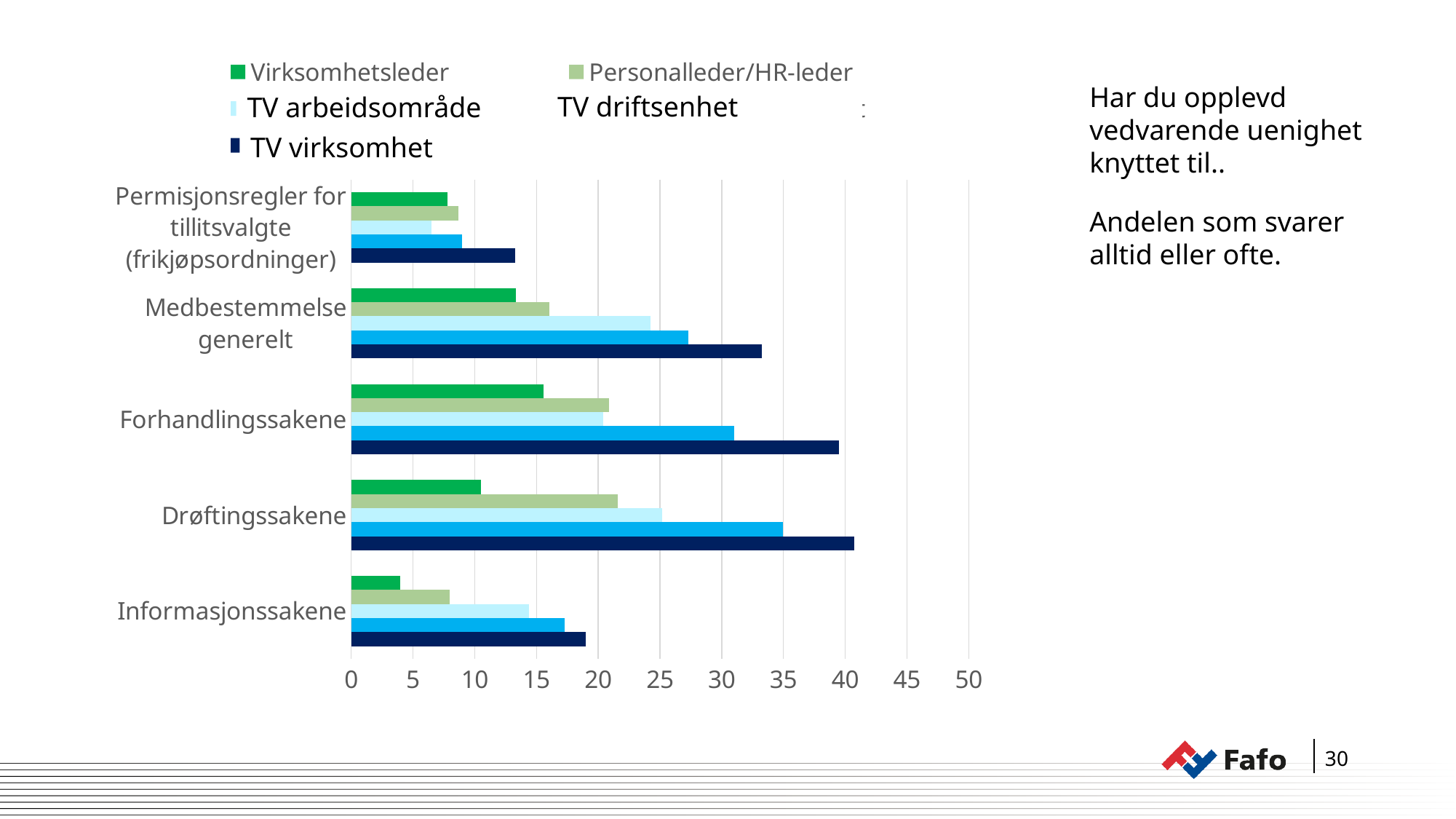
Is the value for TV virksomhet in Forhandlingssakene greater or less than 35? greater Which category has the lowest value for the Virksomhetsleder series? Informasjonssakene How many categories are shown on the vertical axis of the chart? 5 For Drøftingssakene, which is larger: TV arbeidsområde or Personalleder/HR-leder? TV arbeidsområde Is the value for TV virksomhet in Drøftingssakene greater or less than 35? greater Is the value for TV driftsenhet in Drøftingssakene greater or less than 30? greater For Medbestemmelse generelt, which is larger: TV virksomhet or TV driftsenhet? TV virksomhet How many series does the chart's legend list? 5 What kind of chart is shown on the slide? bar chart Which series has the highest value for Permisjonsregler for tillitsvalgte (frikjøpsordninger)? TV virksomhet Which series has the lowest value for Informasjonssakene? Virksomhetsleder